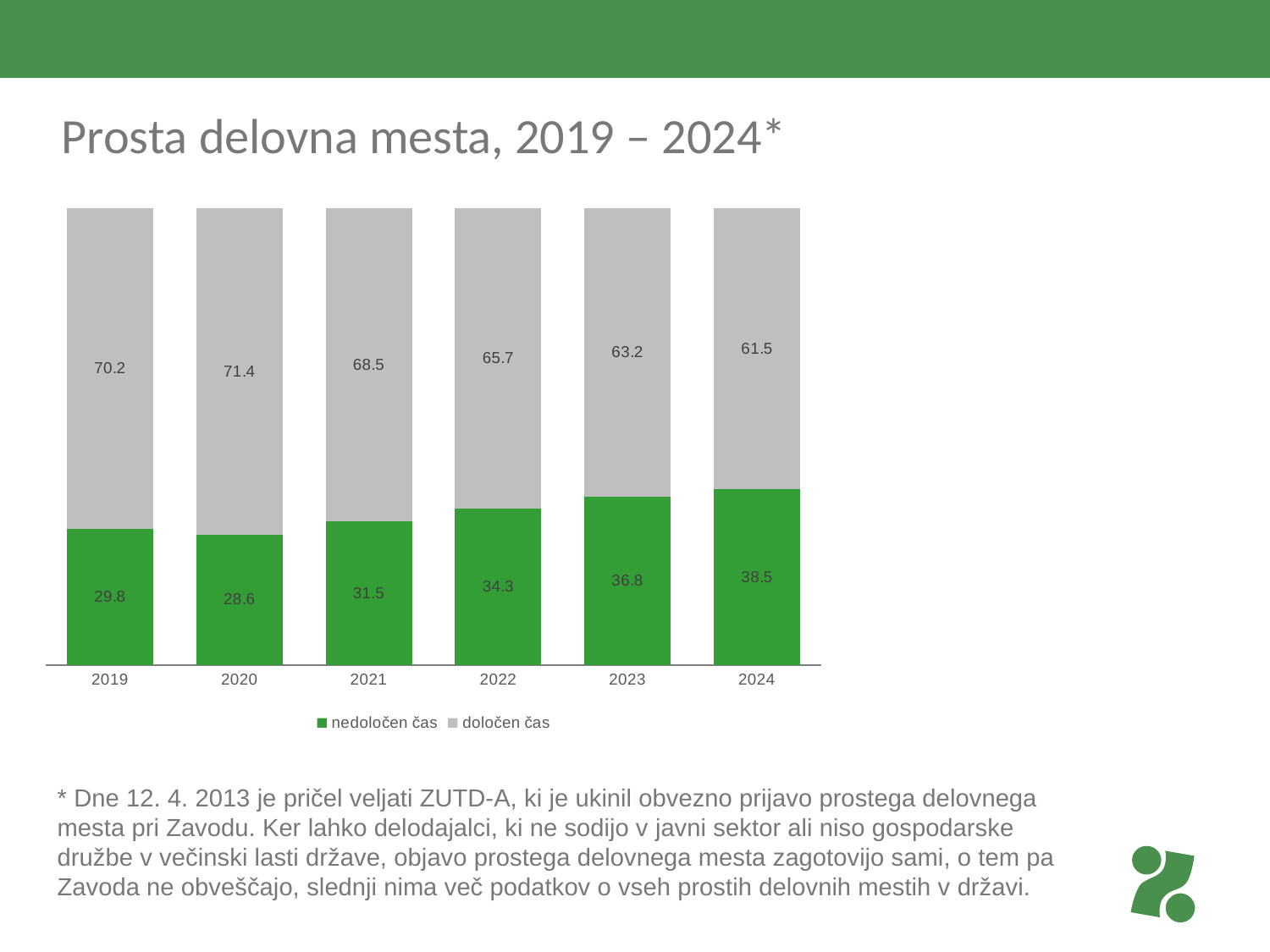
What is the value for "določen čas" in 2024? 61.5 How many years are shown on the x axis? 6 How many series does the legend list? 2 What is the difference between the "določen čas" values for 2020 and 2024? 9.9 In which year is the value for "nedoločen čas" highest? 2024 Which is larger: the "nedoločen čas" value for 2021 or for 2023? 2023 In which year is the value for "določen čas" lowest? 2024 Does the value for "nedoločen čas" rise or fall from 2020 to 2024? Rise What kind of chart is shown on the slide? Stacked bar chart What is the value for "nedoločen čas" in 2022? 34.3 What is the value for "nedoločen čas" in 2019? 29.8 In which year is the value for "nedoločen čas" lowest? 2020